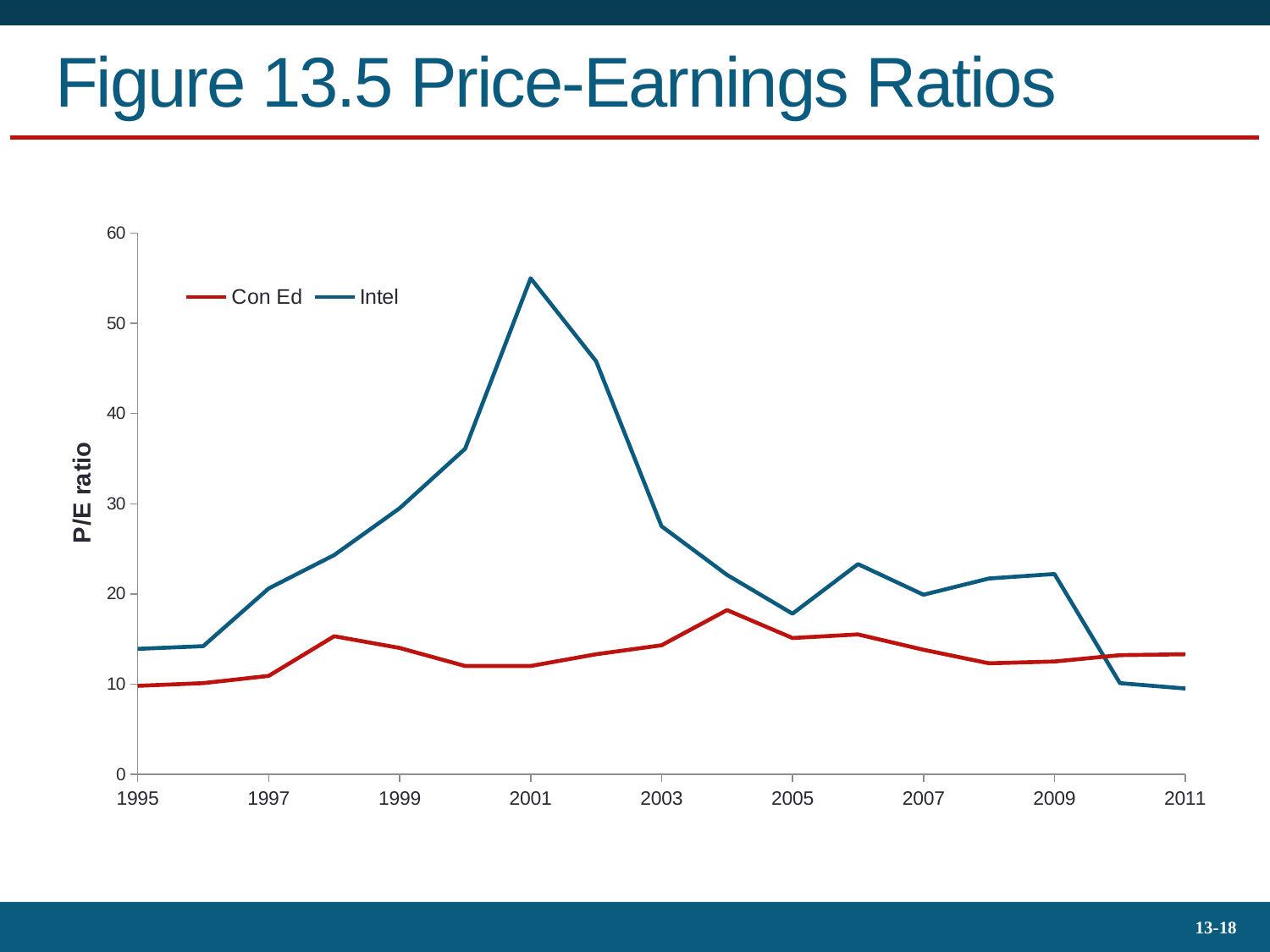
In which year does Intel's P/E ratio reach its highest point? 2001 In 2001, which series has the higher P/E ratio, Con Ed or Intel? Intel Does Intel's P/E ratio rise or fall from 2009 to 2011? fall Is Con Ed's P/E ratio in 1995 greater or less than 20? less Is Intel's P/E ratio in 2005 greater or less than 20? less In 2011, which series has the higher P/E ratio, Con Ed or Intel? Con Ed What are the two series named in the legend? Con Ed and Intel What kind of chart is shown on the slide? line chart Is Intel's P/E ratio in 2001 greater or less than 50? greater What is the label on the vertical axis? P/E ratio How many series does the legend list? 2 In which year does Con Ed's P/E ratio reach its highest point? 2004